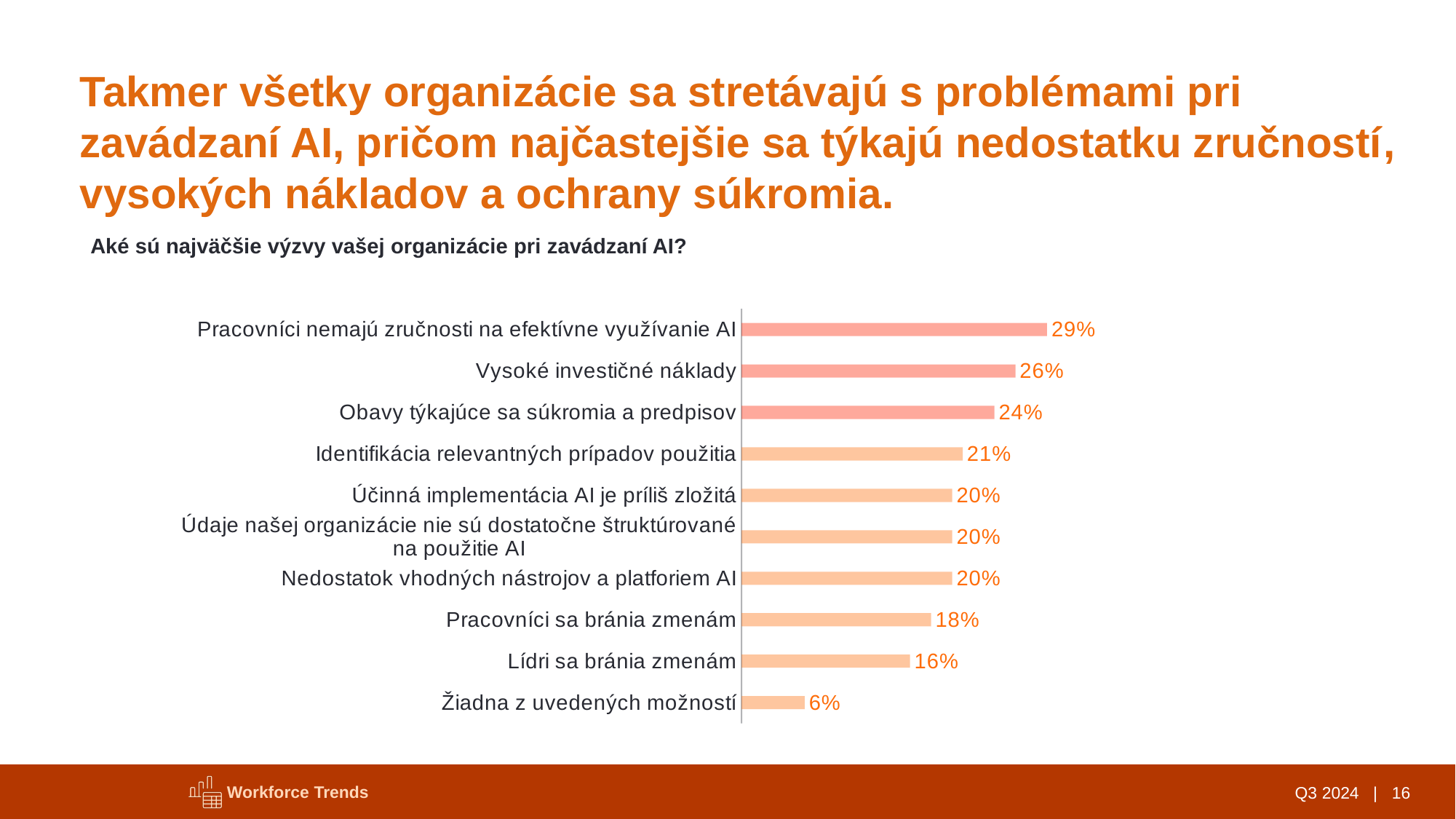
What is the value for "Pracovníci nemajú zručnosti na efektívne využívanie AI"? 29% Which category has the highest value? Pracovníci nemajú zručnosti na efektívne využívanie AI How many categories are shown in the chart? 10 What is the value for "Identifikácia relevantných prípadov použitia"? 21% What kind of chart is shown on the slide? Bar chart What is the difference between "Pracovníci nemajú zručnosti na efektívne využívanie AI" and "Vysoké investičné náklady"? 3% Which category has the lowest value? Žiadna z uvedených možností What is the value for "Lídri sa bránia zmenám"? 16% How many categories have a value of 20%? 3 What is the value for "Vysoké investičné náklady"? 26% What is the difference between "Obavy týkajúce sa súkromia a predpisov" and "Žiadna z uvedených možností"? 18% Which is larger: "Pracovníci sa bránia zmenám" or "Lídri sa bránia zmenám"? Pracovníci sa bránia zmenám